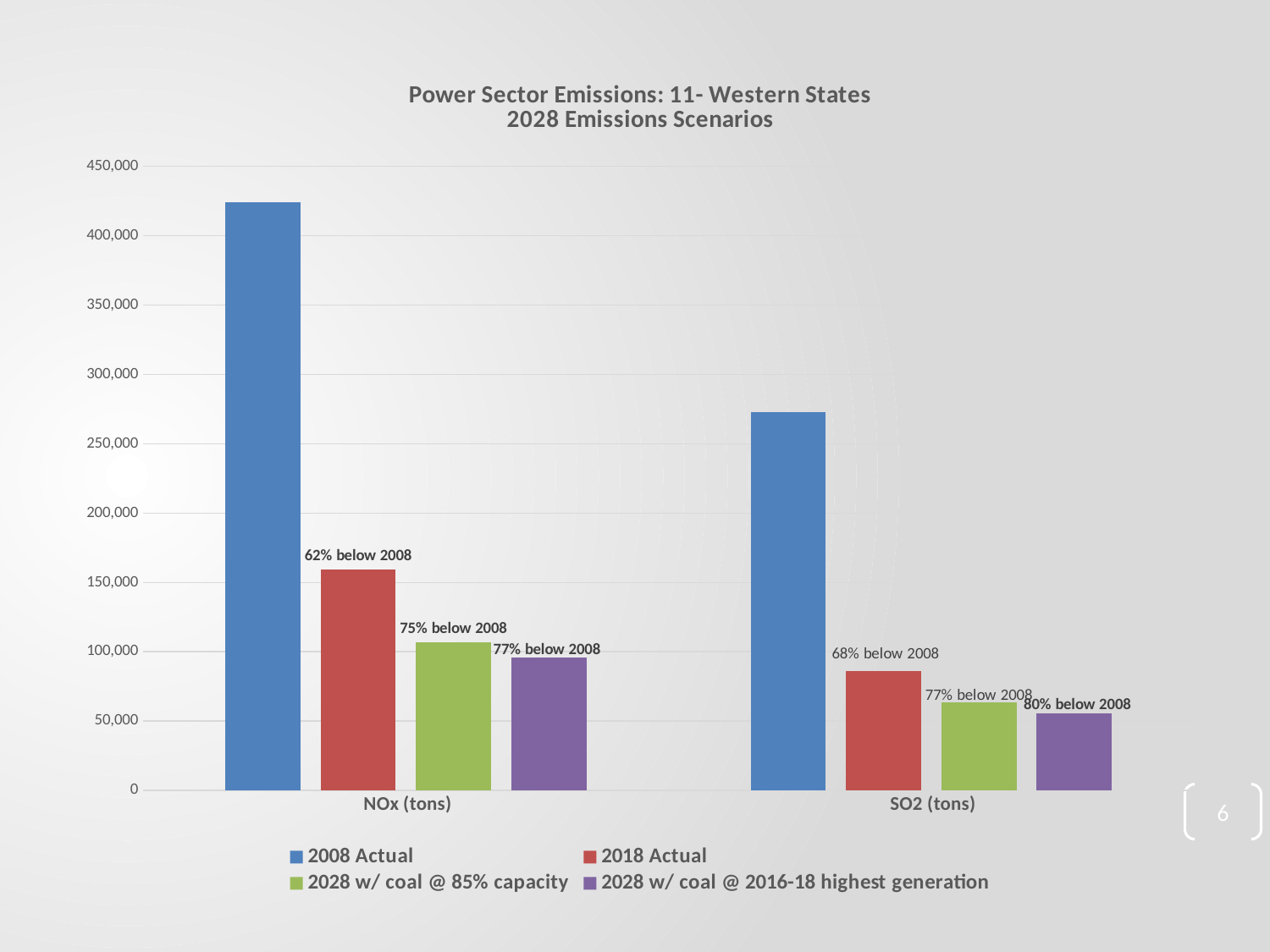
Is the 2008 Actual value for SO2 (tons) greater or less than 300,000? less Which is larger, the 2008 Actual value for NOx (tons) or the 2008 Actual value for SO2 (tons)? NOx (tons) Which series has the highest bar for NOx (tons)? 2008 Actual What data label is printed above the 2018 Actual bar for NOx (tons)? 62% below 2008 How many categories are shown on the x axis? 2 How many series does the legend list? 4 What data label is printed above the 2028 w/ coal @ 2016-18 highest generation bar for SO2 (tons)? 80% below 2008 Which series has the lowest bar for SO2 (tons)? 2028 w/ coal @ 2016-18 highest generation What data label is printed above the 2028 w/ coal @ 85% capacity bar for NOx (tons)? 75% below 2008 What kind of chart is shown on the slide? bar chart What is the title of the chart? Power Sector Emissions: 11- Western States 2028 Emissions Scenarios Is the 2008 Actual value for NOx (tons) greater or less than 400,000? greater